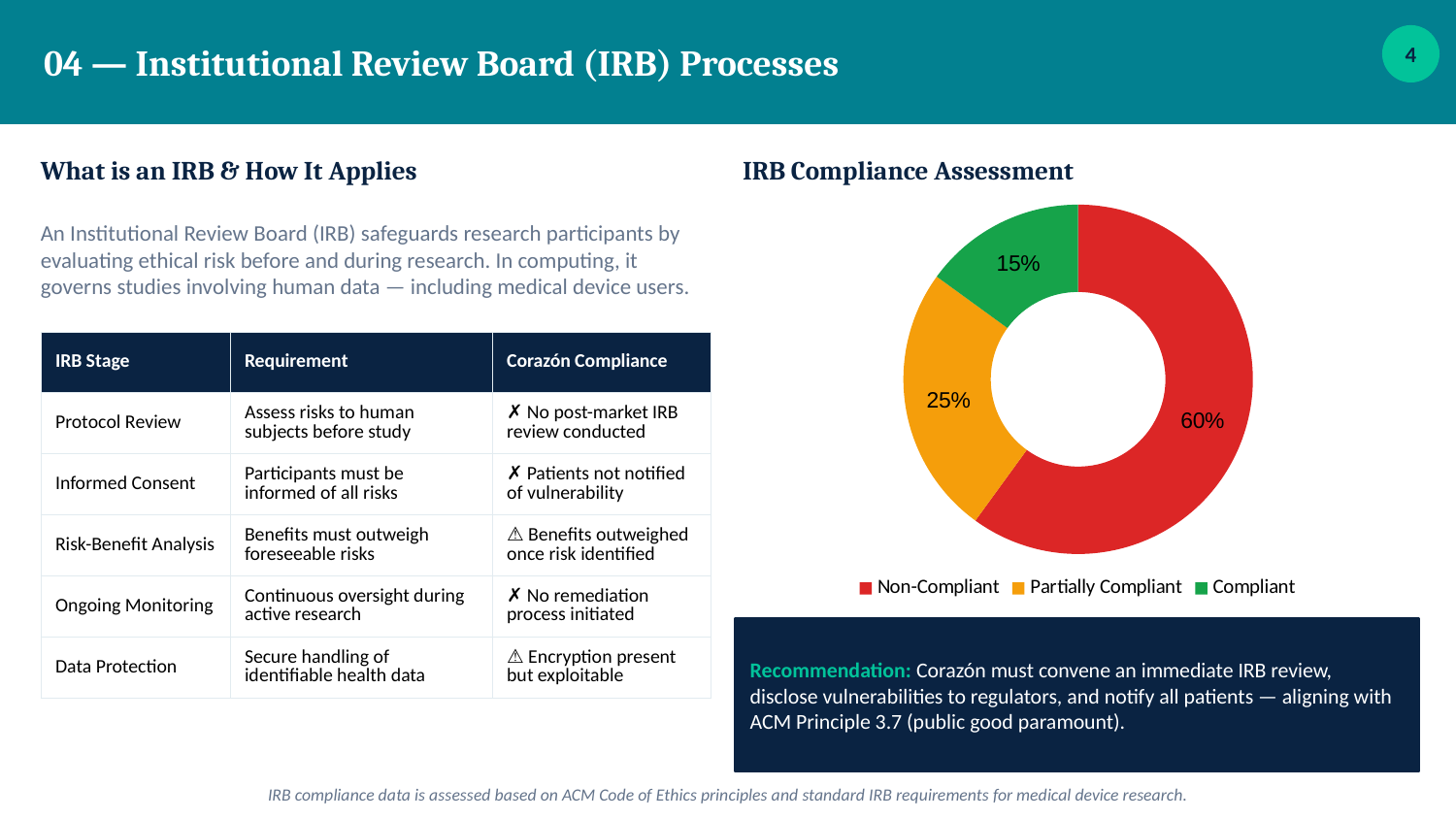
What share of the IRB Compliance Assessment chart is Partially Compliant? 25% How many categories does the IRB Compliance Assessment chart show? 3 What colour represents Non-Compliant in the IRB Compliance Assessment chart? Red In the IRB Compliance Assessment chart, which is larger: Partially Compliant or Compliant? Partially Compliant In the IRB Compliance Assessment chart, what is the difference between the Partially Compliant and Compliant shares? 10% What share of the IRB Compliance Assessment chart is Compliant? 15% What is the title of the chart on the slide? IRB Compliance Assessment Which category has the largest share in the IRB Compliance Assessment chart? Non-Compliant What kind of chart is the IRB Compliance Assessment? Pie chart (donut) What share of the IRB Compliance Assessment chart is Non-Compliant? 60% Which category has the smallest share in the IRB Compliance Assessment chart? Compliant In the IRB Compliance Assessment chart, what is the difference between the Non-Compliant and Partially Compliant shares? 35%